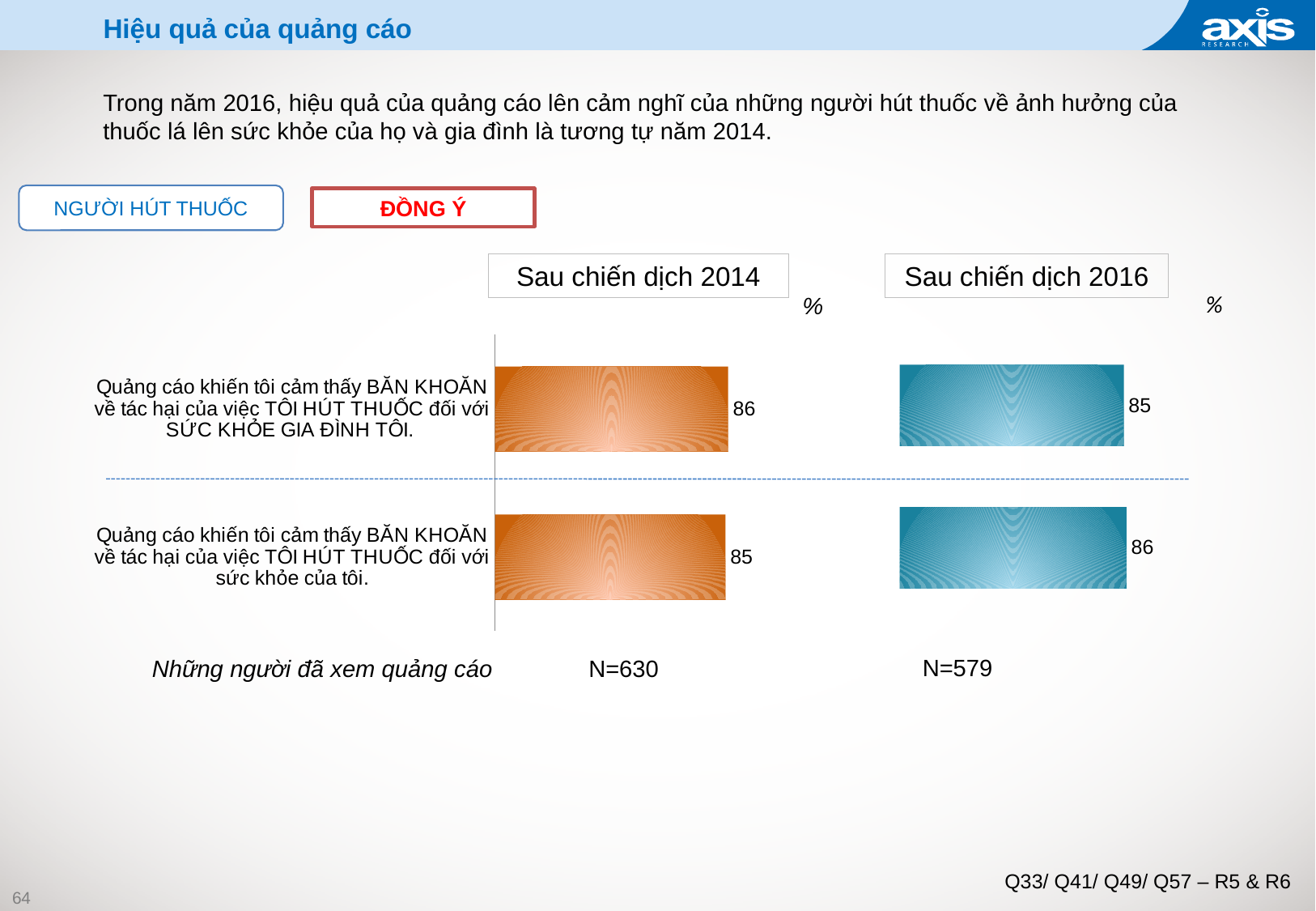
What type of chart is the 'Sau chiến dịch 2014' chart? Bar chart In the 'Sau chiến dịch 2014' chart, what is the value for 'Quảng cáo khiến tôi cảm thấy BĂN KHOĂN về tác hại của việc TÔI HÚT THUỐC đối với sức khỏe của tôi'? 85 In the 'Sau chiến dịch 2014' chart, what is the value for 'Quảng cáo khiến tôi cảm thấy BĂN KHOĂN về tác hại của việc TÔI HÚT THUỐC đối với SỨC KHỎE GIA ĐÌNH TÔI'? 86 How many categories (statements) are shown in the 'Sau chiến dịch 2016' chart? 2 What is the difference between the 2014 and 2016 values for the statement about the family's health (SỨC KHỎE GIA ĐÌNH TÔI)? 1 In the 'Sau chiến dịch 2016' chart, what is the value for 'Quảng cáo khiến tôi cảm thấy BĂN KHOĂN về tác hại của việc TÔI HÚT THUỐC đối với SỨC KHỎE GIA ĐÌNH TÔI'? 85 What colour are the bars in the 'Sau chiến dịch 2014' chart? Orange In the 'Sau chiến dịch 2014' chart, what is the difference between the value for the family health statement and the value for the own health statement? 1 What is the sample size (N) shown under the 'Sau chiến dịch 2016' chart? N=579 How many categories (statements) are shown in the 'Sau chiến dịch 2014' chart? 2 In the 'Sau chiến dịch 2016' chart, what is the difference between the value for the own health statement and the value for the family health statement? 1 In the 'Sau chiến dịch 2016' chart, what is the value for 'Quảng cáo khiến tôi cảm thấy BĂN KHOĂN về tác hại của việc TÔI HÚT THUỐC đối với sức khỏe của tôi'? 86